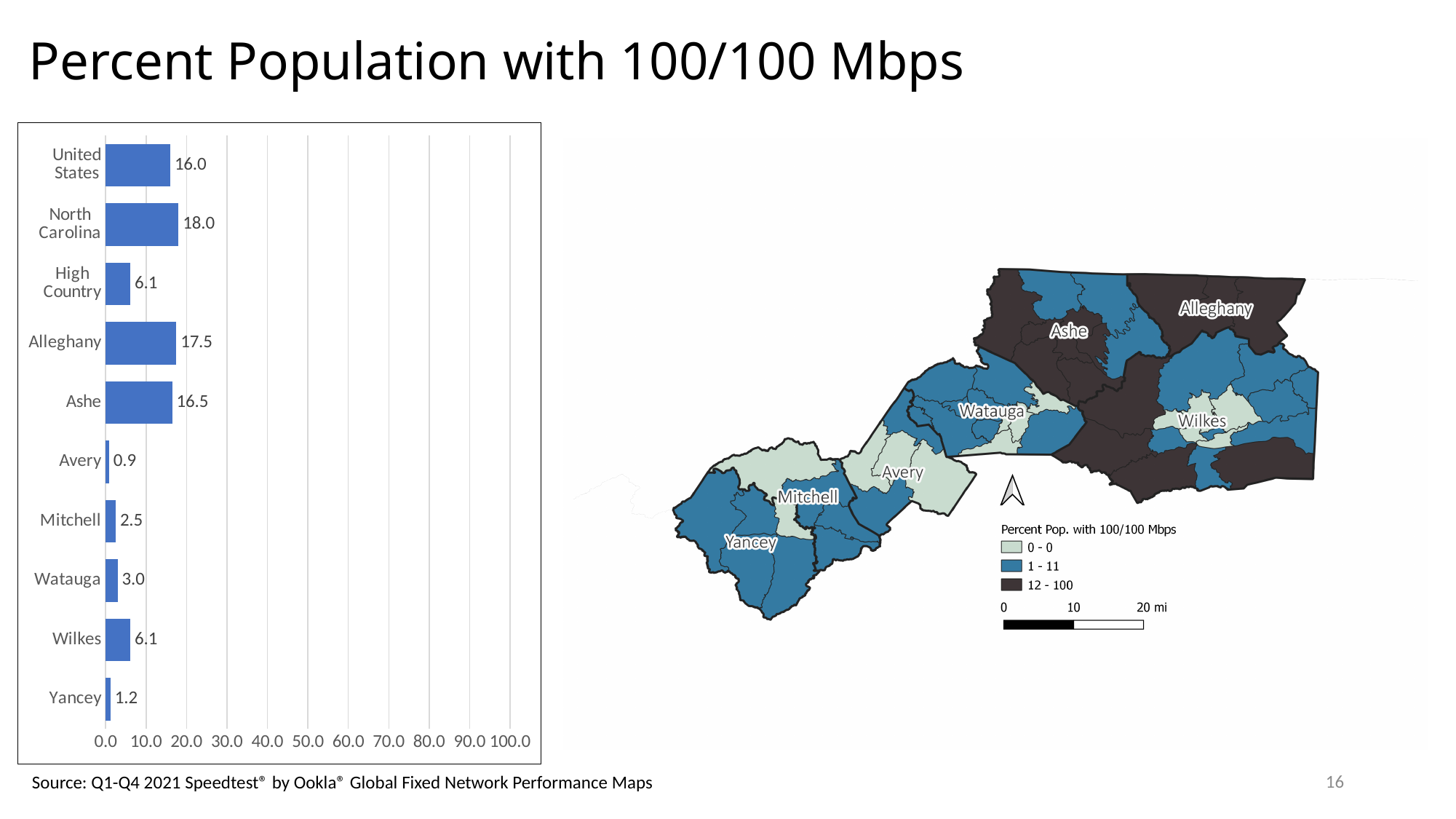
What is the value for Avery in the bar chart? 0.9 Which category has the lowest value in the bar chart? Avery What is the value for North Carolina in the bar chart? 18.0 What kind of chart is shown on the left of the slide? bar chart Which category has the highest value in the bar chart? North Carolina What is the difference between the values for North Carolina and High Country in the bar chart? 11.9 Which has a larger value in the bar chart, Watauga or Mitchell? Watauga Is the value for United States in the bar chart greater or less than 10.0? greater What is the highest value shown on the x axis of the bar chart? 100.0 What is the value for Ashe in the bar chart? 16.5 What is the difference between the values for Alleghany and Ashe in the bar chart? 1.0 How many categories are shown in the bar chart? 10